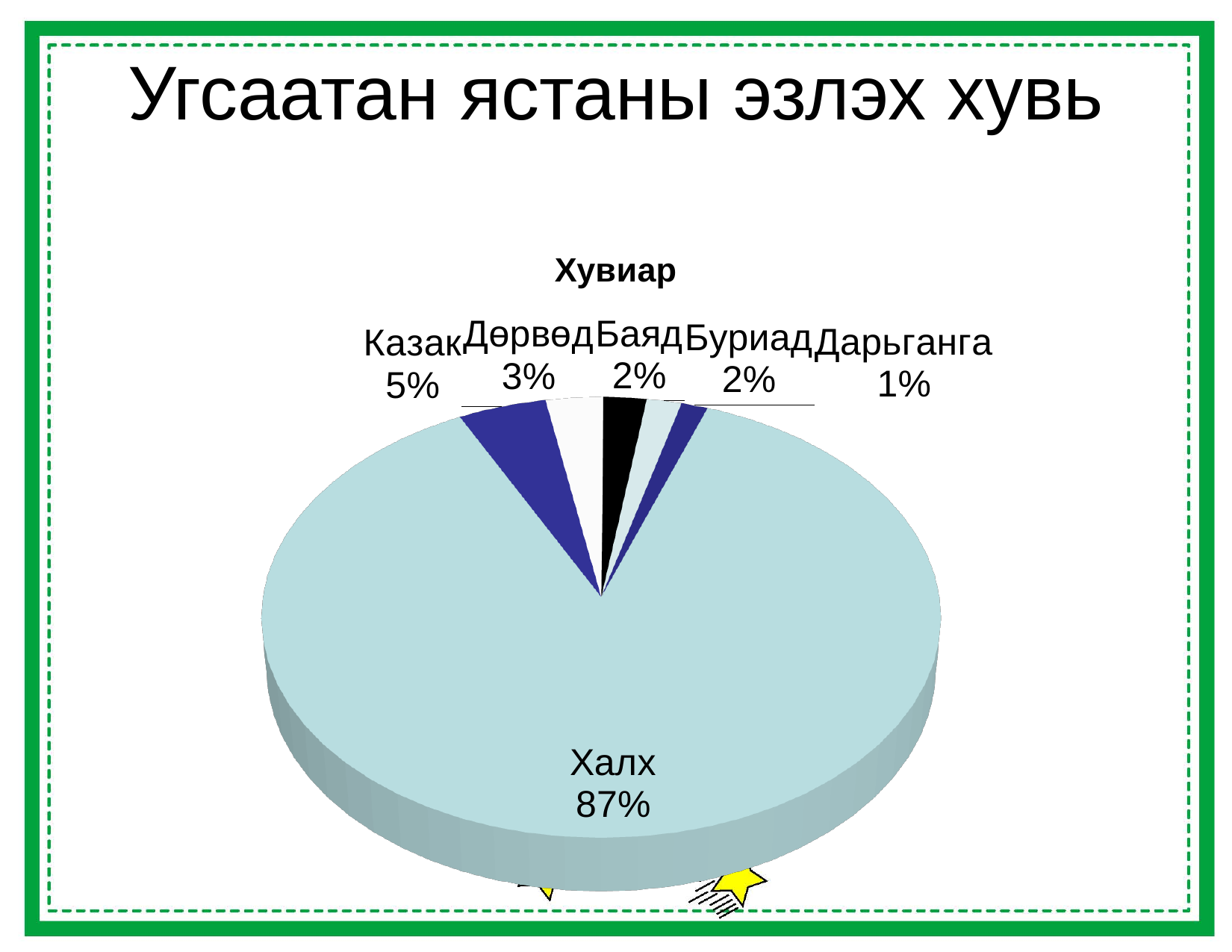
How many slices does the pie chart have? 6 What is the difference between the values for Халх and Казак? 82% What is the value shown for Казак? 5% What is the value shown for Дөрвөд? 3% What is the value shown for Дарьганга? 1% Which is larger, the value for Казак or the value for Дөрвөд? Казак Which category has the smallest slice? Дарьганга Which category has the largest slice? Халх What share of the pie does Халх take? 87% What is the title of the chart? Хувиар What kind of chart is shown on the slide? pie chart What is the value shown for Буриад? 2%